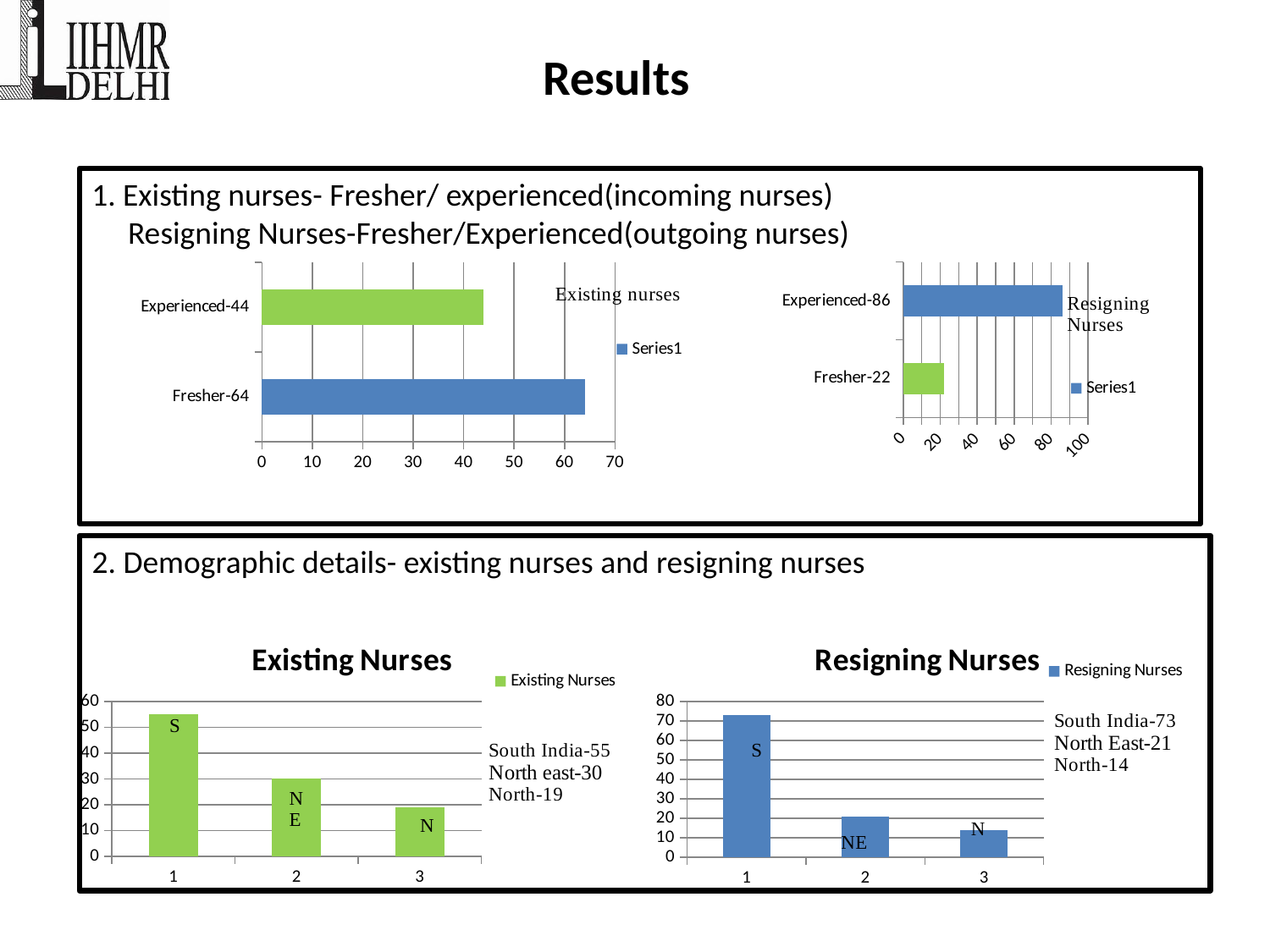
In the 'Existing nurses' chart, what is the value for Experienced? 44 In the 'Resigning Nurses' chart in the bottom section, what is the difference between South India and North? 59 In the 'Existing nurses' chart, what is the difference between the Fresher and Experienced values? 20 What kind of chart is the 'Existing nurses' chart in the top section? Bar chart In the 'Resigning Nurses' chart in the top section, what is the value for Experienced? 86 In the 'Resigning Nurses' chart in the bottom section, what is the value for North East? 21 In the 'Existing nurses' chart, what is the value for Fresher? 64 In the 'Resigning Nurses' chart in the top section, what is the value for Fresher? 22 In the 'Existing Nurses' chart in the bottom section, which region has the lowest value? North In the 'Existing Nurses' chart in the bottom section, what is the value for South India? 55 How many bars are in the 'Resigning Nurses' chart in the bottom section? 3 In the 'Resigning Nurses' chart in the top section, which category is higher, Experienced or Fresher? Experienced